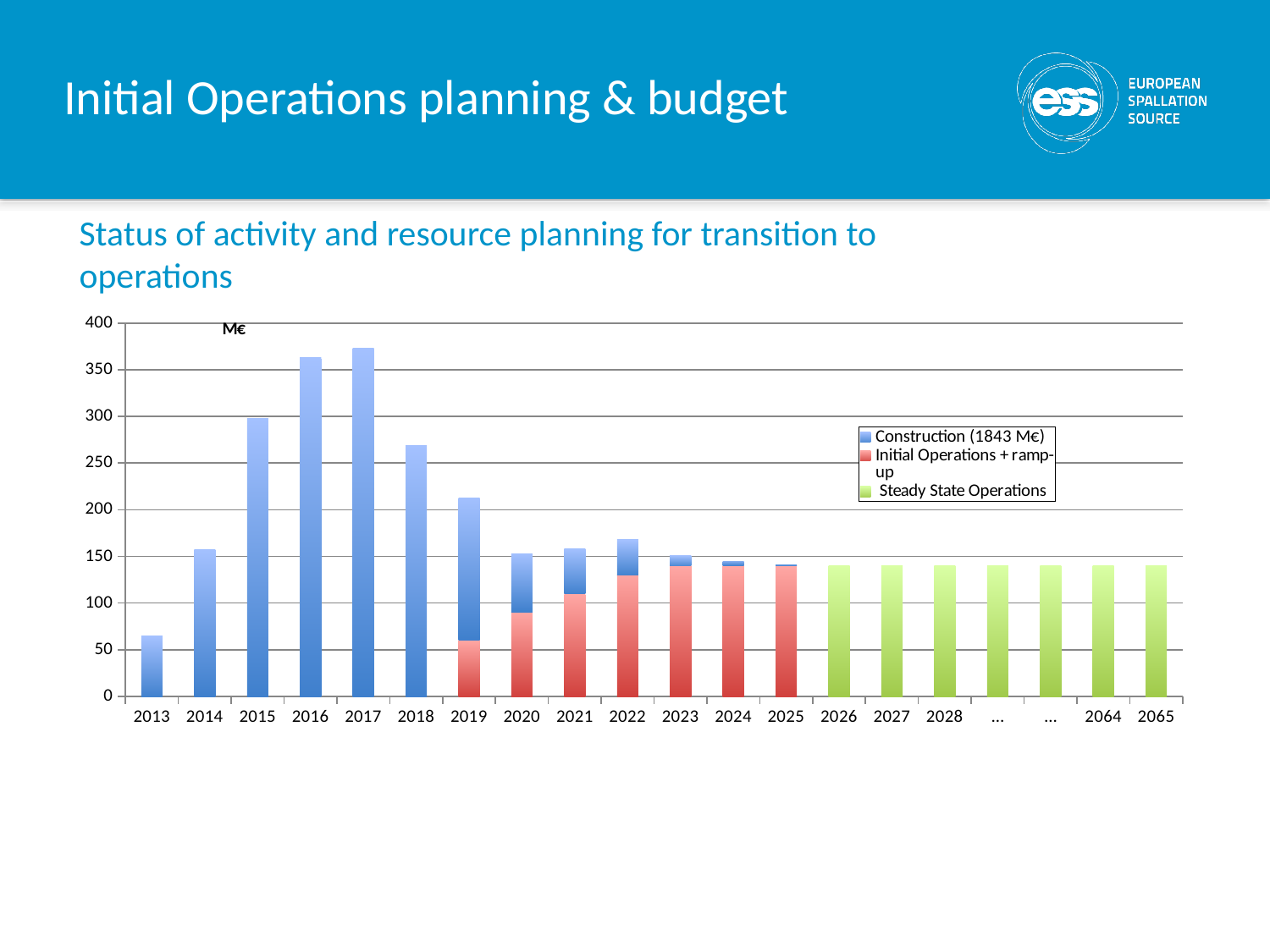
How many series does the legend list? 3 Is the value for 2019 greater or less than 200? greater Is the value for 2026 greater or less than 150? less What is the legend label for the blue series? Construction (1843 M€) Do the bar totals rise or fall from 2017 to 2025? fall Which bar is taller, 2015 or 2018? 2015 How many categories are shown along the x axis? 20 Is the value for 2013 greater or less than 100? less What kind of chart is shown on the slide? bar chart Which year has the shortest bar? 2013 Which year has the tallest bar? 2017